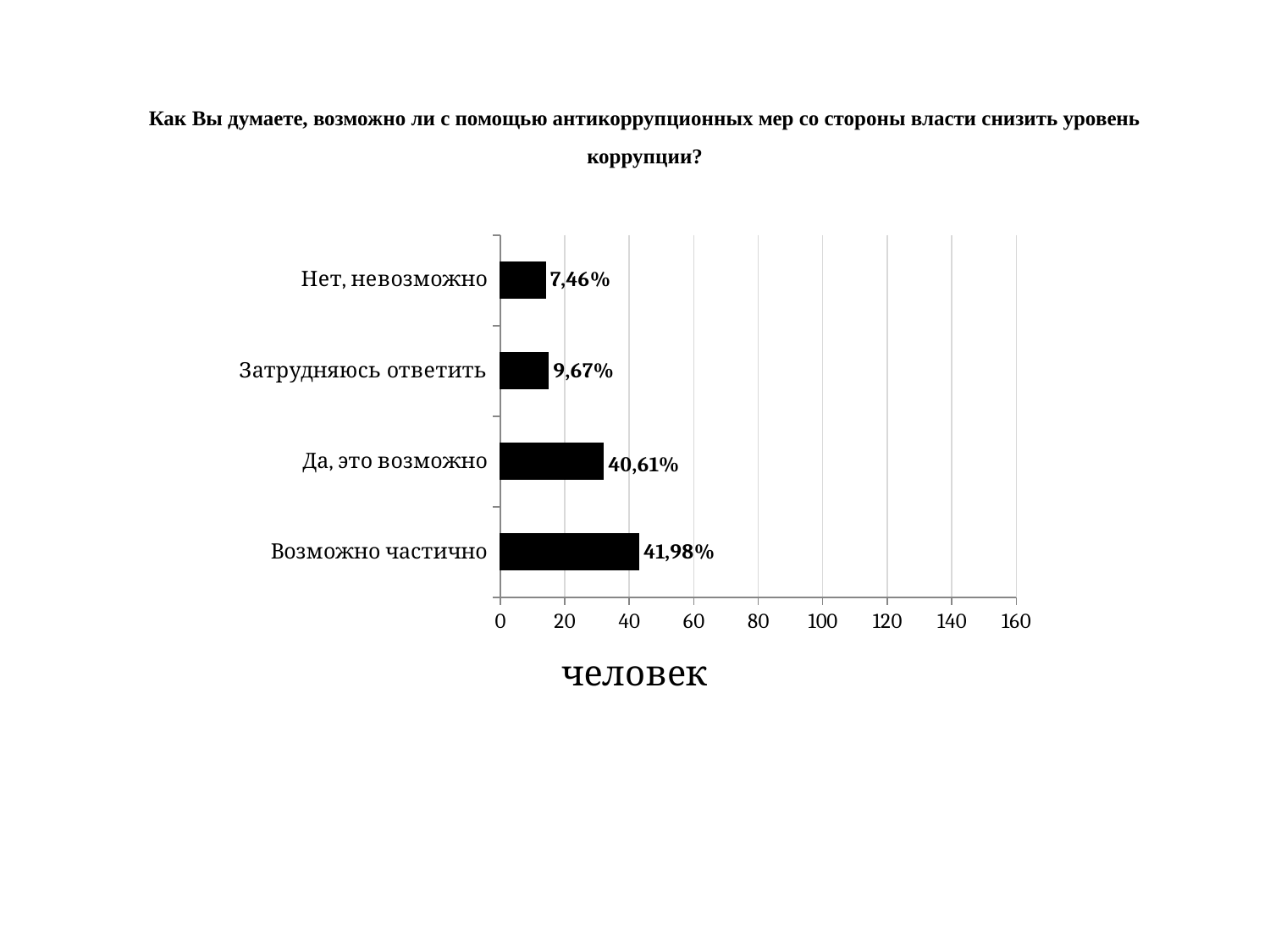
How many categories are shown in the chart? 4 What data label is shown for the bar "Да, это возможно"? 40,61% What data label is shown for the bar "Нет, невозможно"? 7,46% Which category has the lowest value? Нет, невозможно Is the bar for "Возможно частично" greater or less than 60 on the axis? less What type of chart is shown on the slide? Bar chart Is the bar for "Да, это возможно" greater or less than 40 on the axis? less What data label is shown for the bar "Возможно частично"? 41,98% What data label is shown for the bar "Затрудняюсь ответить"? 9,67% Which is larger: the value for "Затрудняюсь ответить" or for "Нет, невозможно"? Затрудняюсь ответить Which category has the highest value? Возможно частично What is the difference between the data labels for "Затрудняюсь ответить" and "Нет, невозможно"? 2,21%